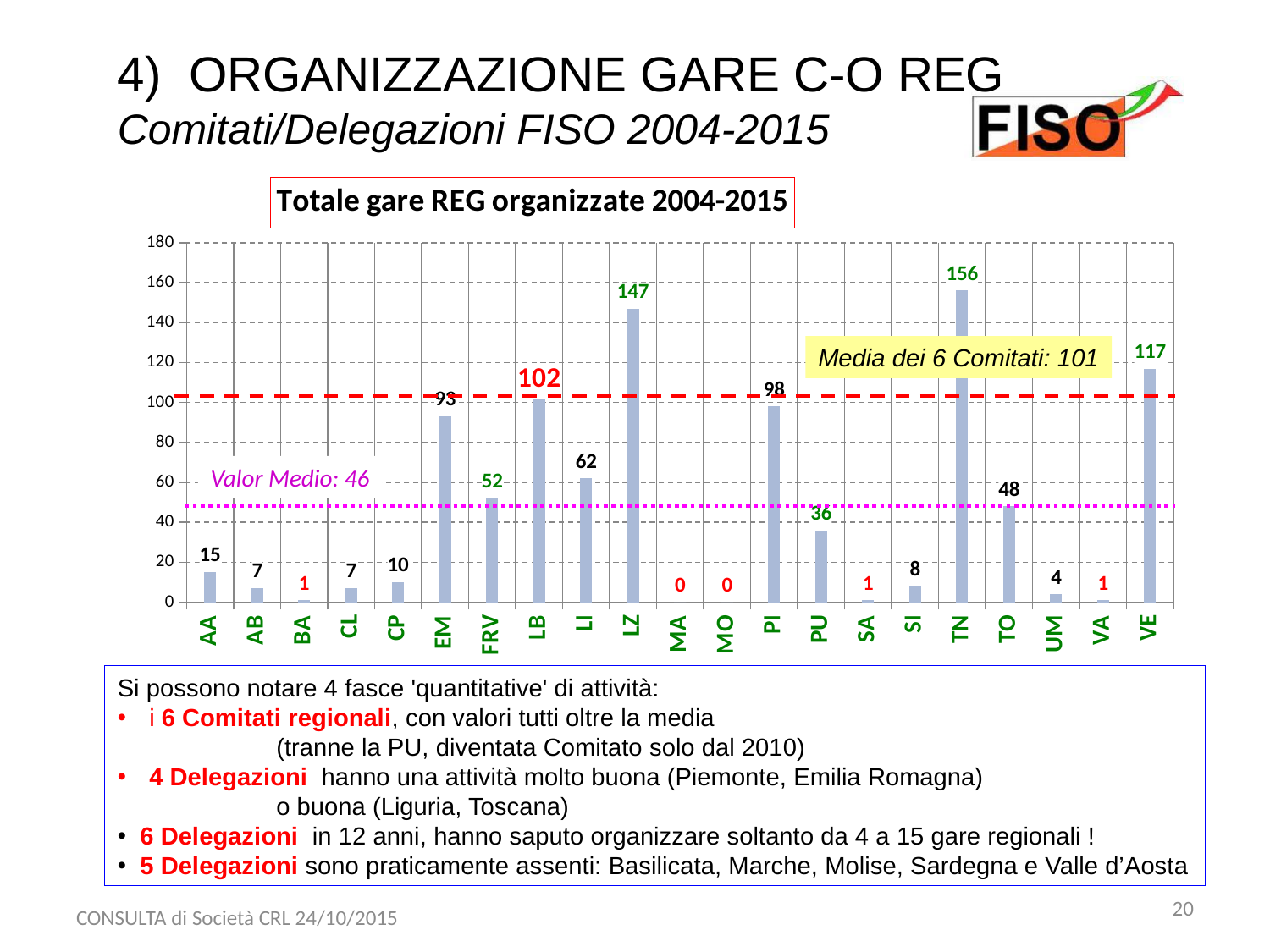
What is the title of the chart? Totale gare REG organizzate 2004-2015 What is the value for PU in the chart? 36 Which is larger, the value for PI or the value for EM? PI What is the difference between the values for TN and LZ? 9 Which category has the highest value in the chart? TN What is the difference between the values for VE and EM? 24 Which is larger, the value for LI or the value for FRV? LI How many categories are shown on the x axis of the chart? 21 What kind of chart is shown on the slide? Bar chart What is the value for LZ in the chart? 147 What is the value for TN in the chart? 156 What value does the 'Valor Medio' label on the chart give? 46